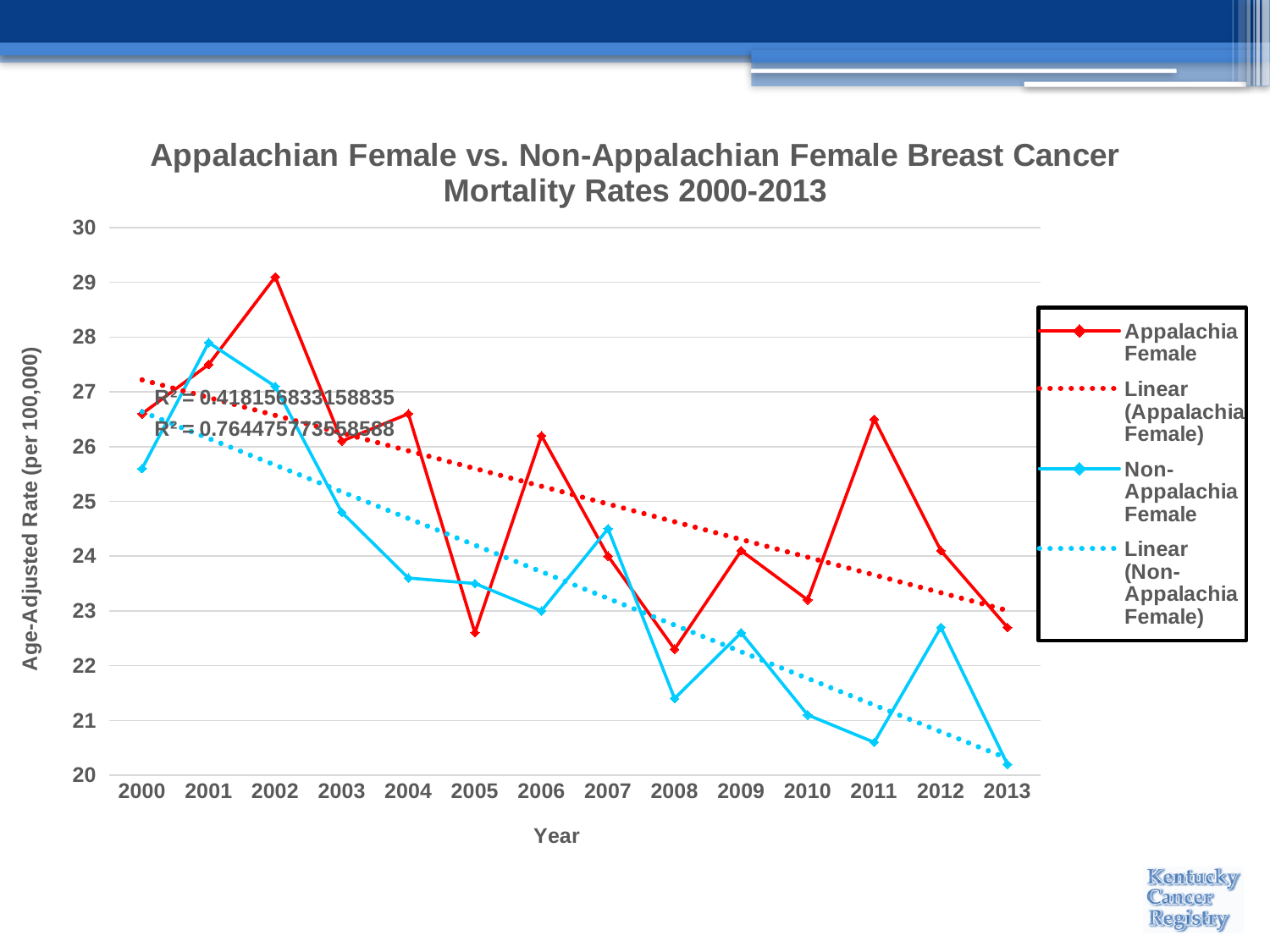
What kind of chart is shown on the slide? Line chart What is the label on the y axis of the chart? Age-Adjusted Rate (per 100,000) In which year does the Non-Appalachia Female mortality rate reach its highest value? 2001 Overall, do the Non-Appalachia Female mortality rates rise or fall from 2000 to 2013? Fall Is the Appalachia Female rate in 2002 greater or less than 28? greater How many years are plotted along the x axis? 14 In which year does the Appalachia Female mortality rate reach its highest value? 2002 Is the Appalachia Female rate in 2005 greater or less than 23? less In which year does the Non-Appalachia Female mortality rate reach its lowest value? 2013 Is the Non-Appalachia Female rate in 2013 greater or less than 21? less In 2013, which series has the higher mortality rate, Appalachia Female or Non-Appalachia Female? Appalachia Female How many entries does the legend list? 4